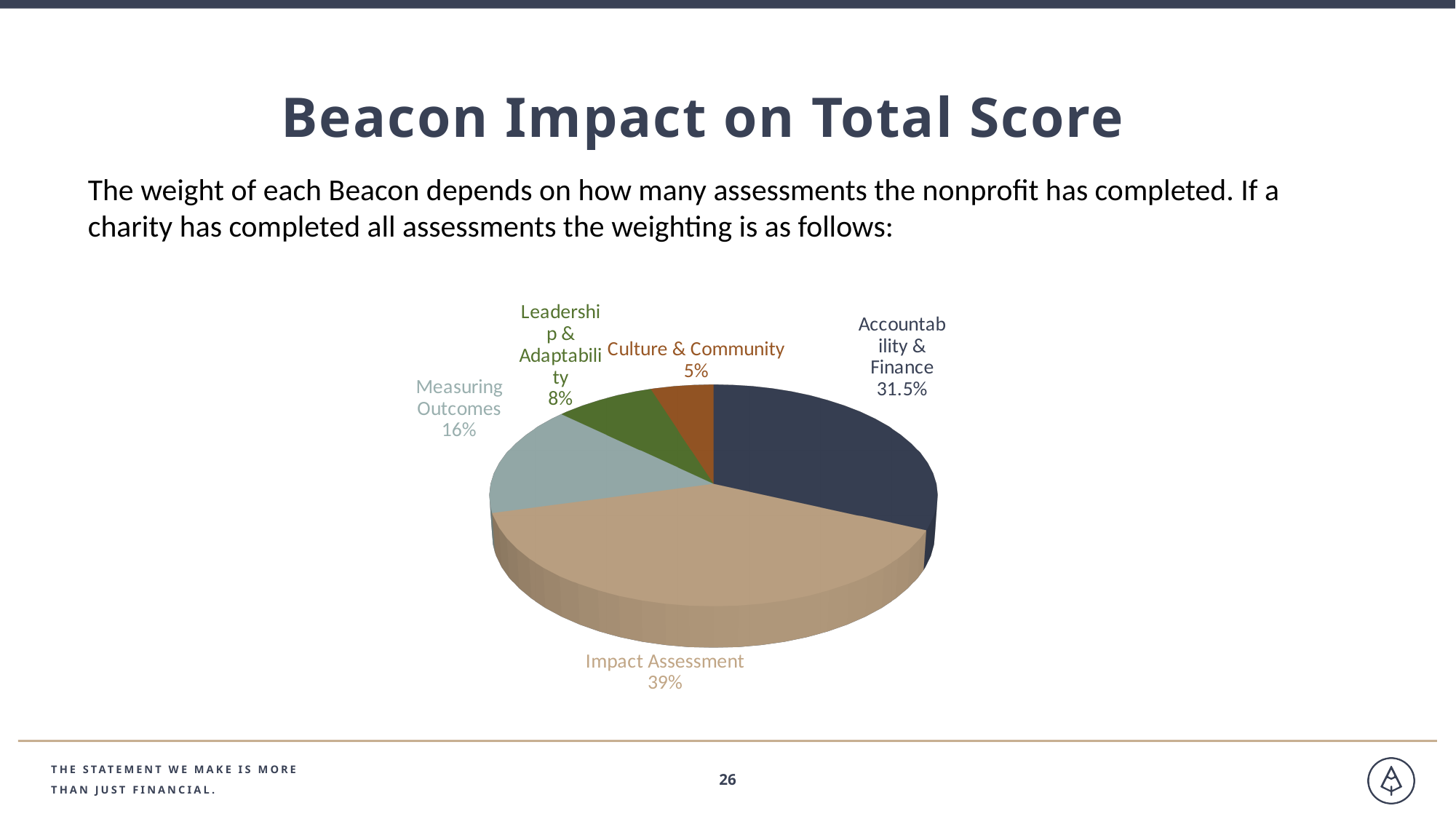
What is the difference between the Impact Assessment and Accountability & Finance weightings? 7.5% What share of the total score does Impact Assessment account for? 39% How many slices does the pie chart have? 5 What percentage is shown for Culture & Community? 5% Which Beacon has the smallest share of the total score? Culture & Community Which has a larger weighting, Measuring Outcomes or Leadership & Adaptability? Measuring Outcomes What is the weighting for Leadership & Adaptability? 8% Which Beacon has the largest share of the total score? Impact Assessment What is the weighting for Accountability & Finance? 31.5% What kind of chart is shown on the slide? Pie chart What percentage is shown for Measuring Outcomes? 16% What is the title of the slide containing the pie chart? Beacon Impact on Total Score